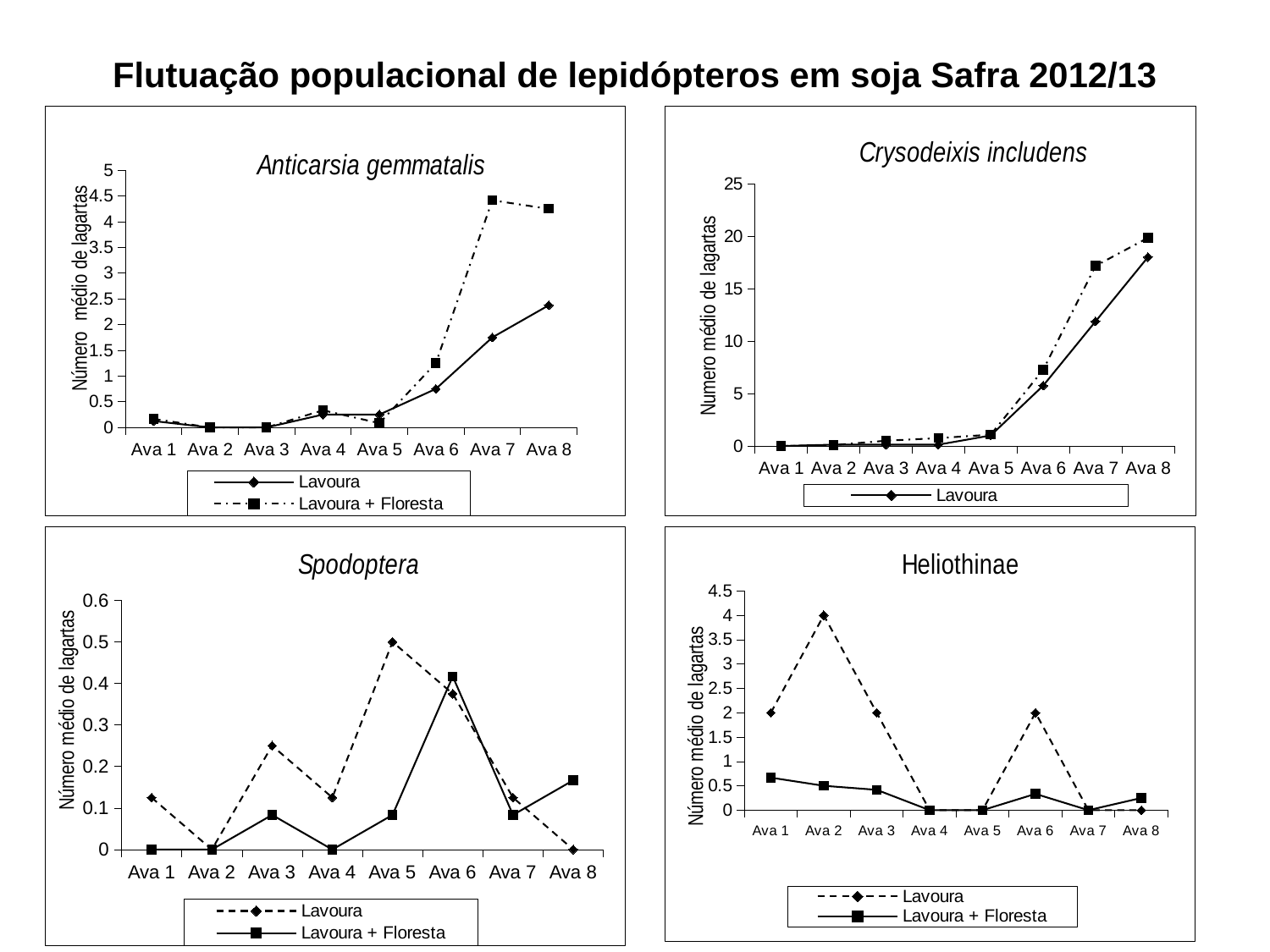
In the Heliothinae chart, what is the difference between the Lavoura values at Ava 2 and Ava 1? 2 In the Heliothinae chart, at which evaluation is the Lavoura series highest? Ava 2 In the Anticarsia gemmatalis chart, at which evaluation does the Lavoura series reach its highest value? Ava 8 In the Spodoptera chart, what is the Lavoura value at Ava 5? 0.5 How many evaluation points (Ava) are on the x axis of the Crysodeixis includens chart? 8 In the Spodoptera chart, at Ava 5, which series has the larger value, Lavoura or Lavoura + Floresta? Lavoura In the Crysodeixis includens chart, is the Lavoura value at Ava 8 greater or less than 15? greater In the Anticarsia gemmatalis chart, is the Lavoura + Floresta value at Ava 7 greater or less than 4? greater How many series does the legend of the Heliothinae chart list? 2 What kind of chart is the Anticarsia gemmatalis chart? line chart How many charts are shown on the slide? 4 In the Heliothinae chart, what is the Lavoura value at Ava 2? 4